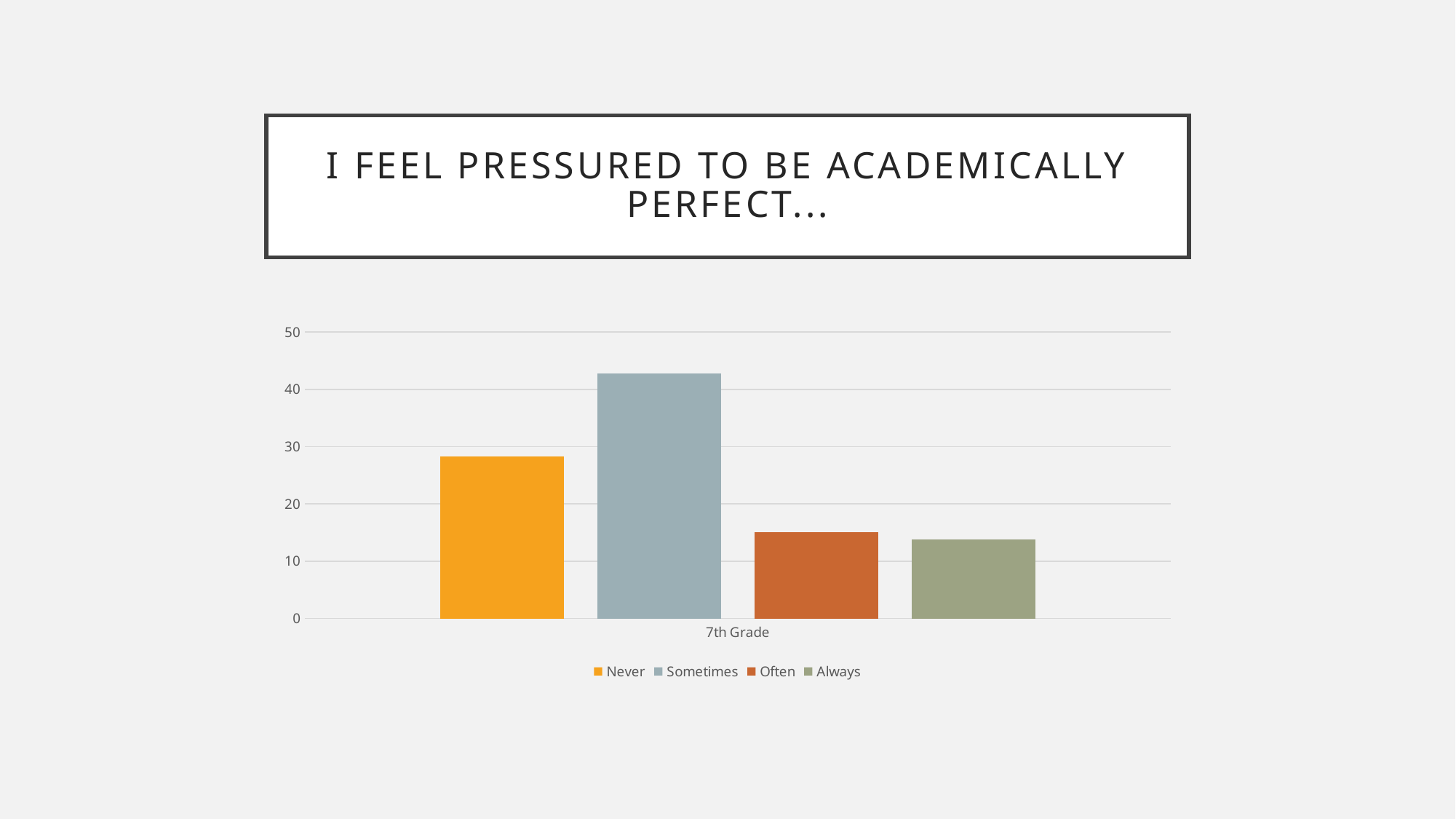
Which response has the highest value for 7th Grade? Sometimes Is the value for Never greater or less than 30? less How many series does the legend list? 4 How many categories are shown on the x axis? 1 Is the value for Often greater or less than 20? less What kind of chart is shown on the slide? bar chart Which is larger, the value for Never or the value for Sometimes? Sometimes Which is larger, the value for Never or the value for Often? Never What is the category label shown on the x axis? 7th Grade Is the value for Always greater or less than 10? greater